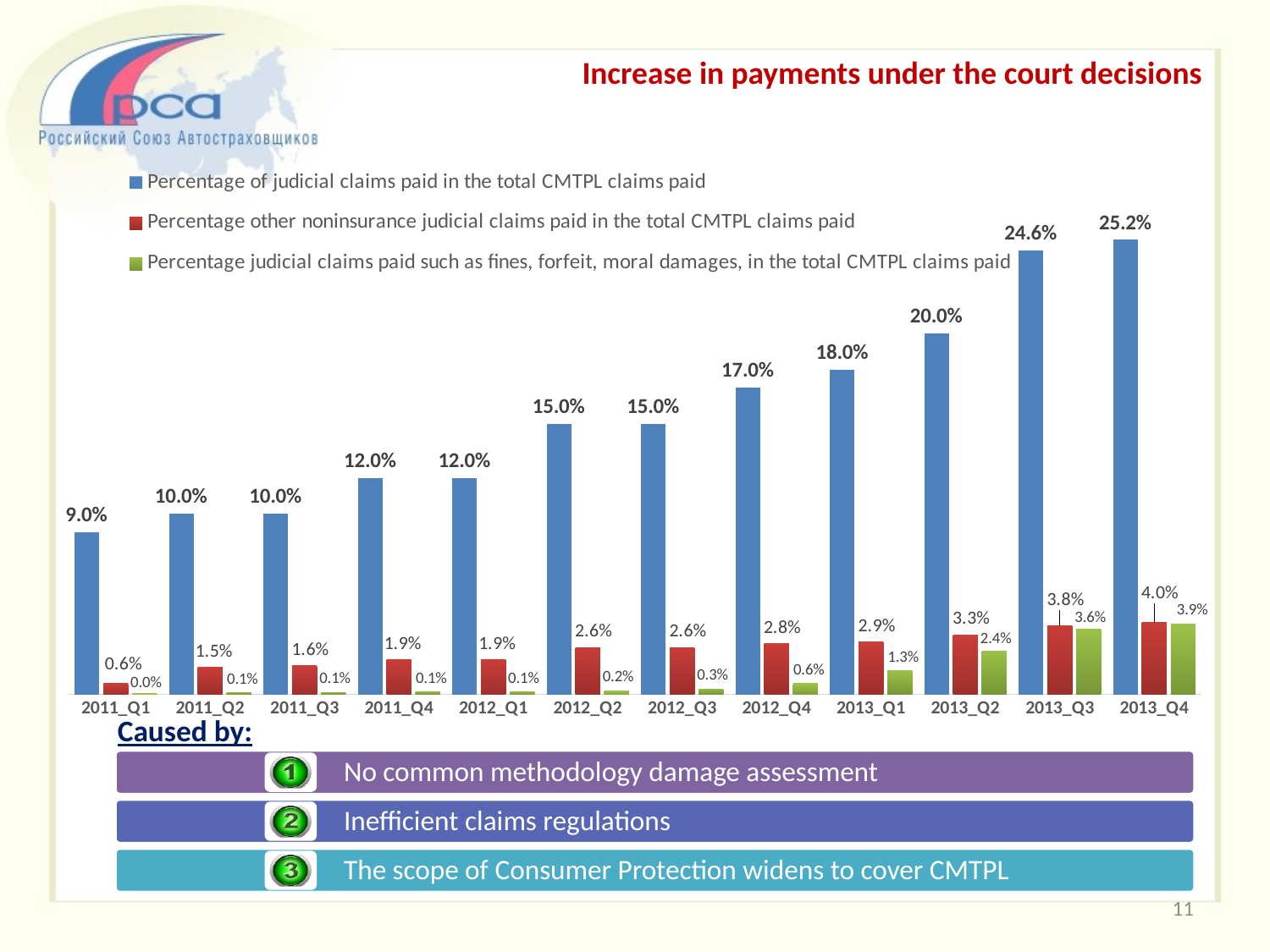
How many series does the chart legend list? 3 What is the percentage of judicial claims paid in the total CMTPL claims paid for 2013_Q4? 25.2% What is the percentage of judicial claims paid such as fines, forfeit, moral damages for 2013_Q2? 2.4% In which quarter is the percentage of judicial claims paid in the total CMTPL claims paid the lowest? 2011_Q1 What is the difference between the percentage of judicial claims paid in the total CMTPL claims paid in 2013_Q4 and in 2011_Q1? 16.2% In which quarter is the percentage of judicial claims paid such as fines, forfeit, moral damages the highest? 2013_Q4 Does the percentage of judicial claims paid in the total CMTPL claims paid rise or fall from 2011_Q1 to 2013_Q4? Rise Which is larger in 2013_Q3: the percentage of other noninsurance judicial claims paid or the percentage of judicial claims paid such as fines, forfeit, moral damages? Percentage other noninsurance judicial claims paid What kind of chart is shown on the slide? Bar chart What is the percentage of other noninsurance judicial claims paid in the total CMTPL claims paid for 2012_Q2? 2.6% How many quarters are shown on the x axis of the chart? 12 What is the title of the chart on the slide? Increase in payments under the court decisions